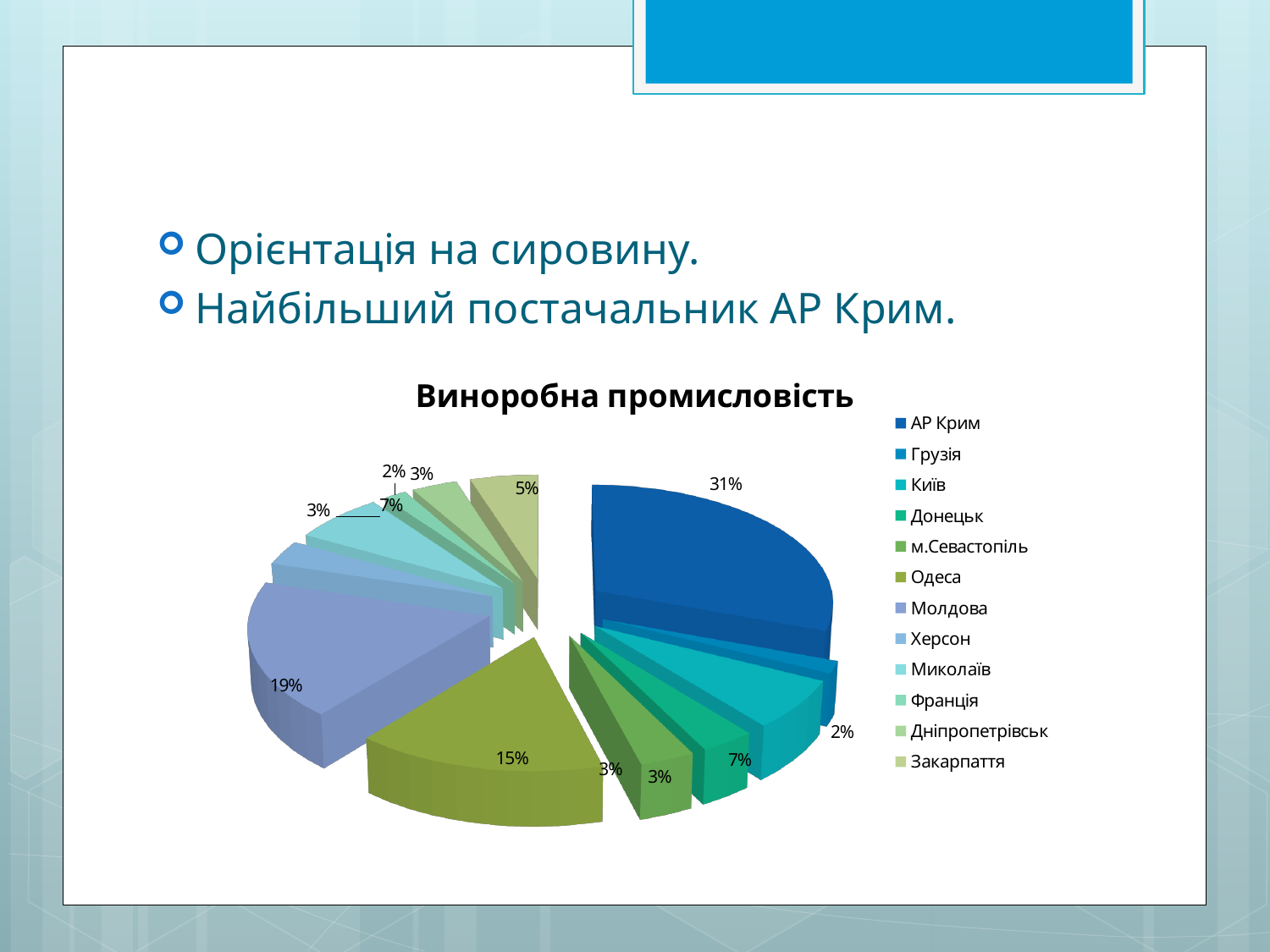
What is the difference between the share of Одеса and the share of Закарпаття? 10% What kind of chart is shown on the slide? pie chart Which category has the largest slice of the pie? АР Крим What is the difference between the share of АР Крим and the share of Молдова? 12% Which is larger, the slice for Молдова or the slice for Одеса? Молдова What share of the pie does АР Крим hold? 31% Which legend entry is listed first in the chart legend? АР Крим What is the title of the chart? Виноробна промисловість What share of the pie does Одеса hold? 15% What share of the pie does Молдова hold? 19% How many entries does the chart legend list? 12